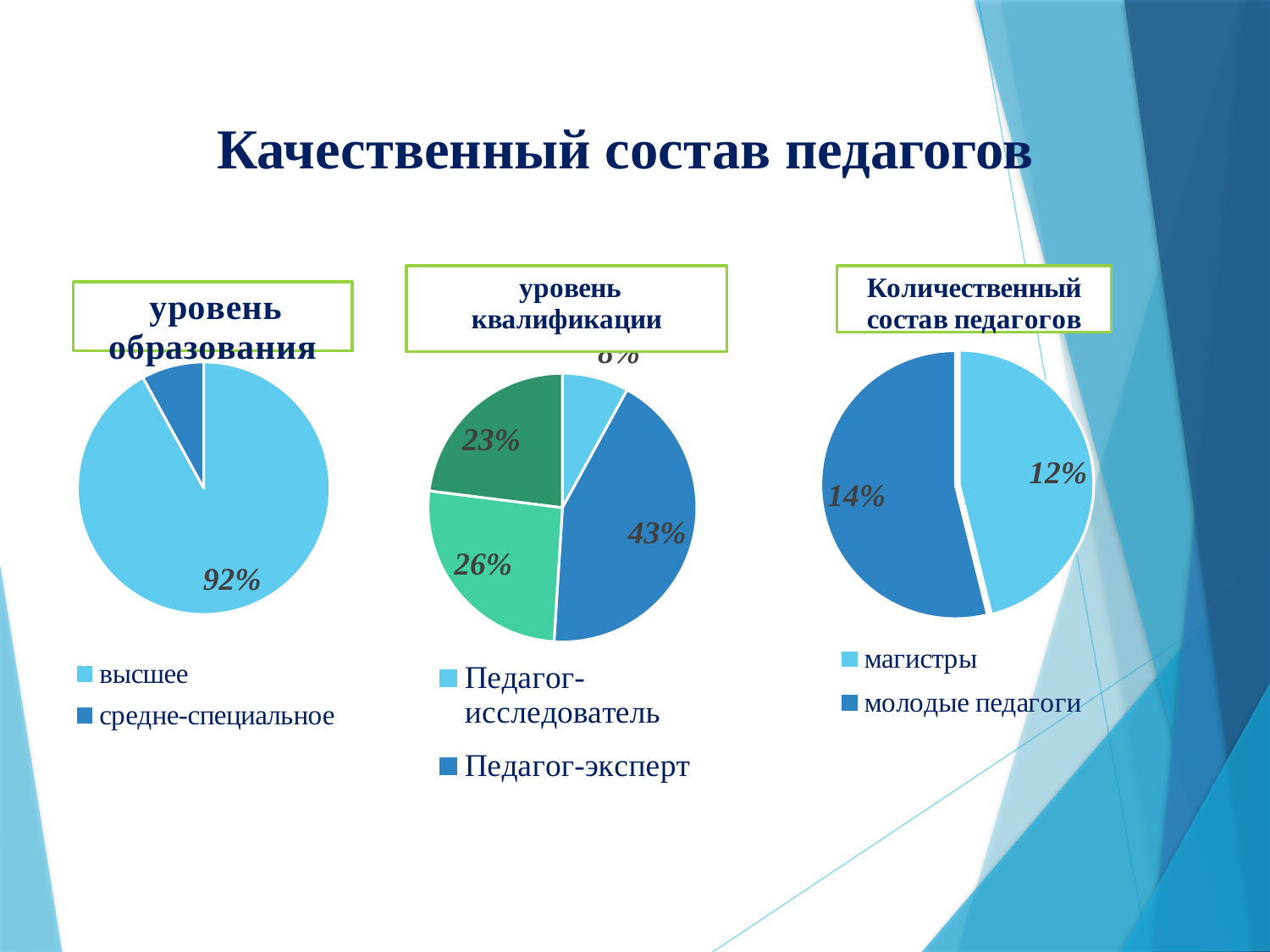
How many pie charts are shown on the slide? 3 In the 'Количественный состав педагогов' chart, what percentage is shown for молодые педагоги? 14% In the 'уровень образования' chart, which category has the largest slice? высшее In the 'уровень квалификации' chart, which slice is larger: Педагог-эксперт or Педагог-исследователь? Педагог-эксперт What kind of chart is the 'уровень образования' chart? pie chart In the 'уровень квалификации' chart, what is the largest percentage shown? 43% How many slices does the 'уровень квалификации' pie chart have? 4 In the 'Количественный состав педагогов' chart, what is the difference between the percentages for молодые педагоги and магистры? 2% How many entries does the legend of the 'уровень образования' chart list? 2 In the 'уровень квалификации' chart, what percentage is shown for Педагог-эксперт? 43% In the 'уровень образования' chart, what percentage is shown for высшее? 92% In the 'Количественный состав педагогов' chart, what percentage is shown for магистры? 12%